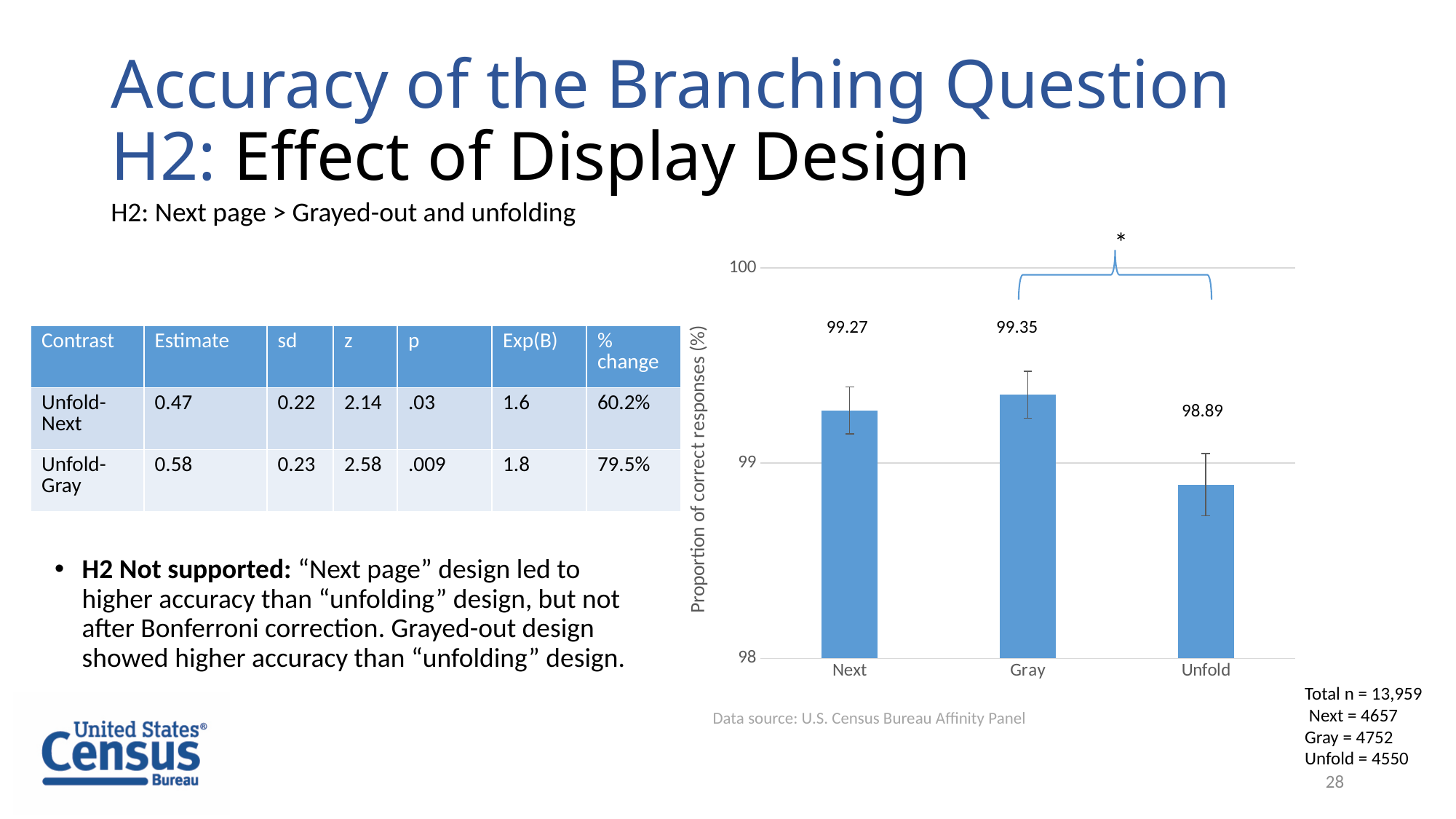
What is the label of the vertical axis of the bar chart? Proportion of correct responses (%) What is the difference between the values for Next and Unfold in the bar chart? 0.38 What kind of chart is shown on the slide? bar chart What is the value for Gray in the bar chart? 99.35 How many categories are shown in the bar chart? 3 What is the value for Next in the bar chart? 99.27 Which category has the highest value in the bar chart? Gray Is the value for Unfold in the bar chart greater or less than 99? less What is the value for Unfold in the bar chart? 98.89 Which category has the lowest value in the bar chart? Unfold Which is larger in the bar chart, the value for Next or the value for Unfold? Next What is the difference between the values for Gray and Unfold in the bar chart? 0.46